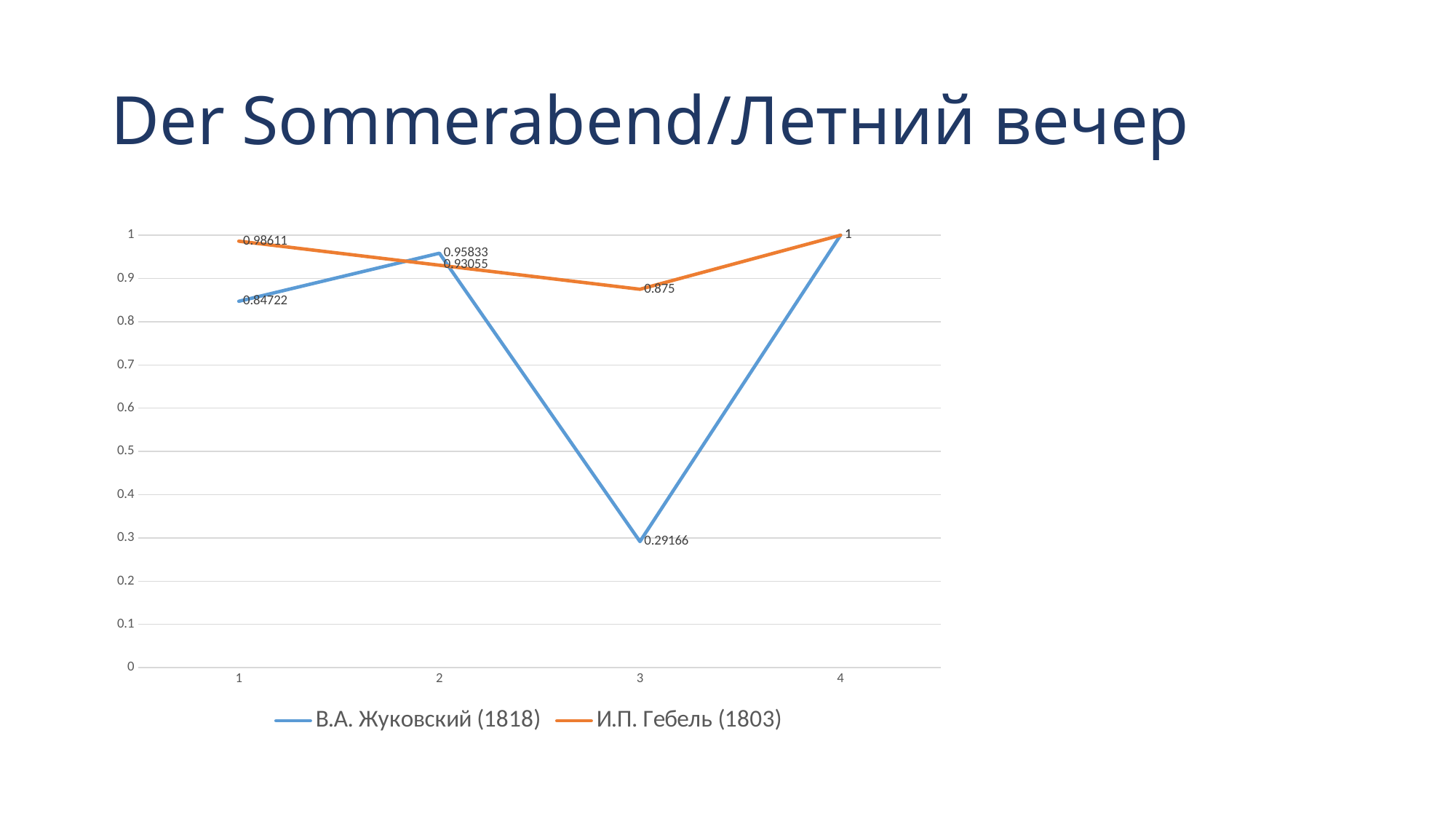
How many series does the legend list? 2 At which point does И.П. Гебель (1803) reach its highest value? 4 What is the value for И.П. Гебель (1803) at point 3? 0.875 What is the value for В.А. Жуковский (1818) at point 3? 0.29166 How many points are plotted along the x axis for each series? 4 Which series has the larger value at point 3, В.А. Жуковский (1818) or И.П. Гебель (1803)? И.П. Гебель (1803) What is the title of the slide above the chart? Der Sommerabend/Летний вечер What is the value for И.П. Гебель (1803) at point 1? 0.98611 At which point does В.А. Жуковский (1818) reach its lowest value? 3 What is the value for В.А. Жуковский (1818) at point 1? 0.84722 What kind of chart is shown on the slide? line chart Is the value for В.А. Жуковский (1818) at point 3 greater or less than 0.5? less